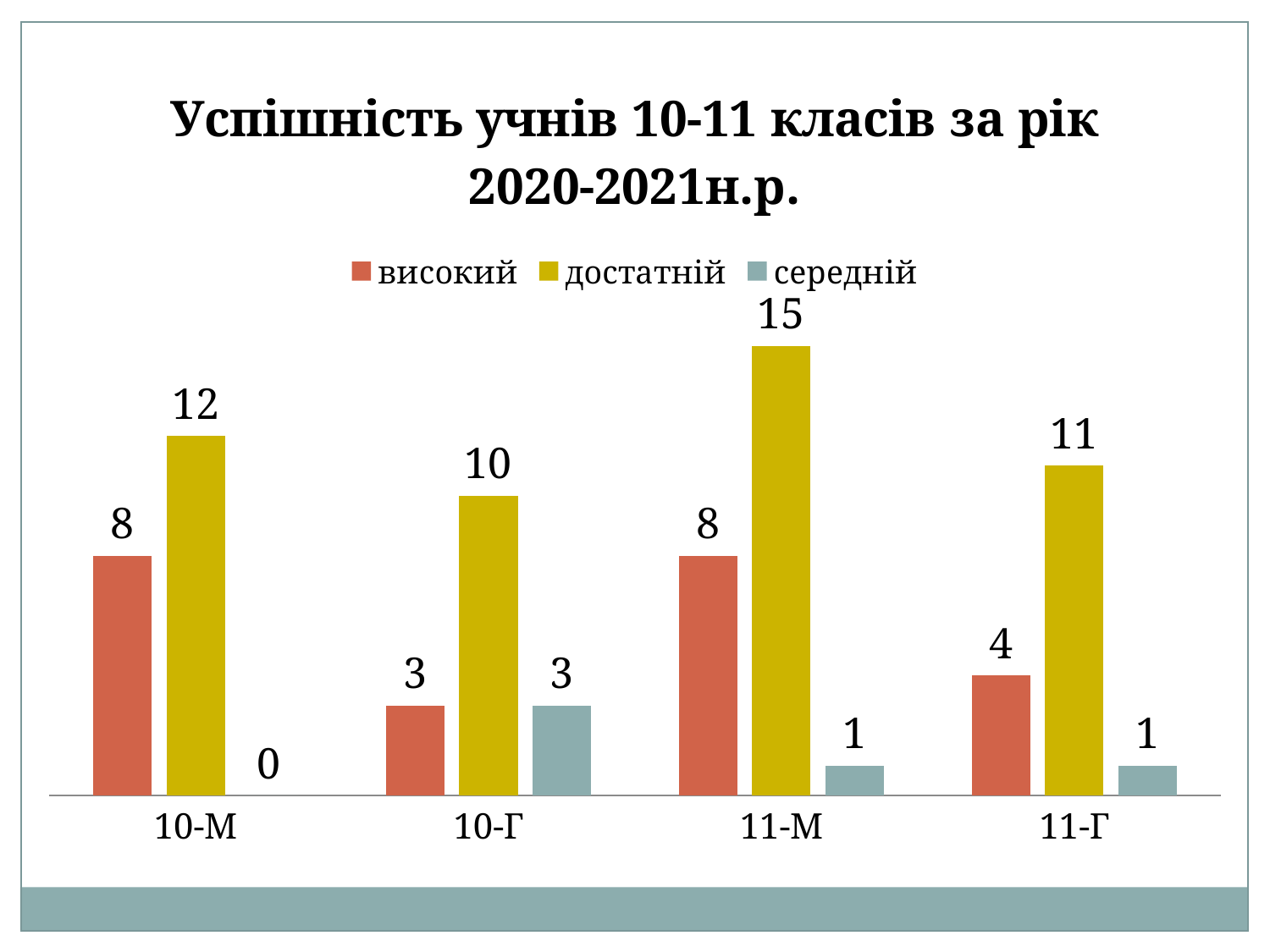
How many series does the legend list? 3 Which category has the highest value for "достатній"? 11-М What is the value for "високий" in the 11-Г category? 4 What is the value for "достатній" in the 11-М category? 15 How many categories are shown on the x axis? 4 What kind of chart is shown on the slide? bar chart Which category has the lowest value for "високий"? 10-Г What is the title of the chart? Успішність учнів 10-11 класів за рік 2020-2021н.р. What colour are the bars for the "середній" series? grey-blue What is the value for "середній" in the 10-М category? 0 Which is larger: the "достатній" value for 10-М or for 11-Г? 11-Г What is the difference between the "достатній" values for 11-М and 10-Г? 5